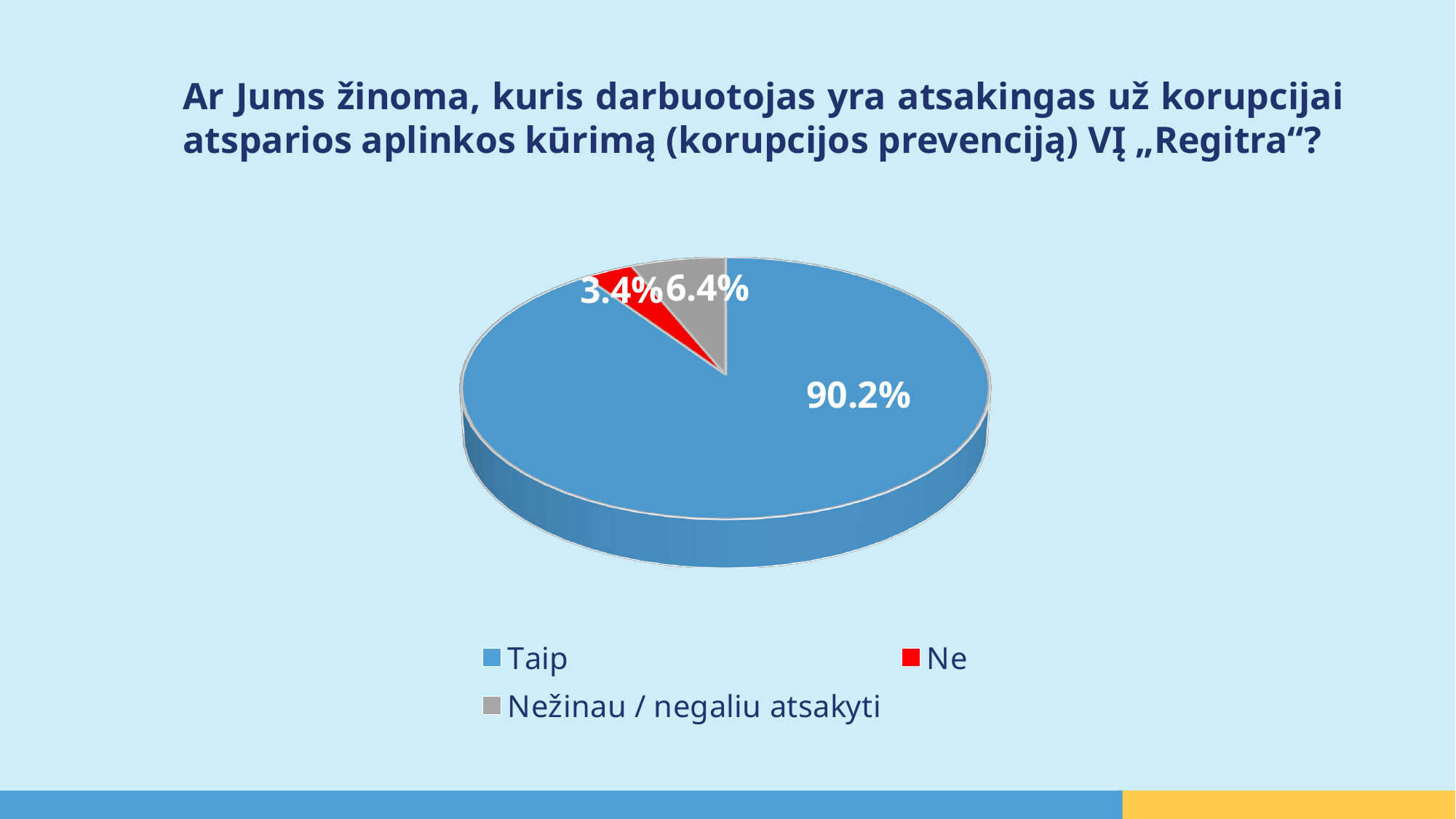
How many slices does the pie chart have? 3 Which answer has the largest share of the pie? Taip What share of respondents answered "Ne"? 3.4% Which answer has the smallest share of the pie? Ne What share of respondents answered "Nežinau / negaliu atsakyti"? 6.4% Which is larger, the share for "Ne" or the share for "Nežinau / negaliu atsakyti"? Nežinau / negaliu atsakyti What colour is the slice for "Ne"? red What kind of chart is shown on the slide? pie chart What is the difference in percentage points between the "Taip" share and the "Nežinau / negaliu atsakyti" share? 83.8 How many entries does the legend list? 3 What is the difference in percentage points between the "Nežinau / negaliu atsakyti" share and the "Ne" share? 3.0 What share of respondents answered "Taip"? 90.2%